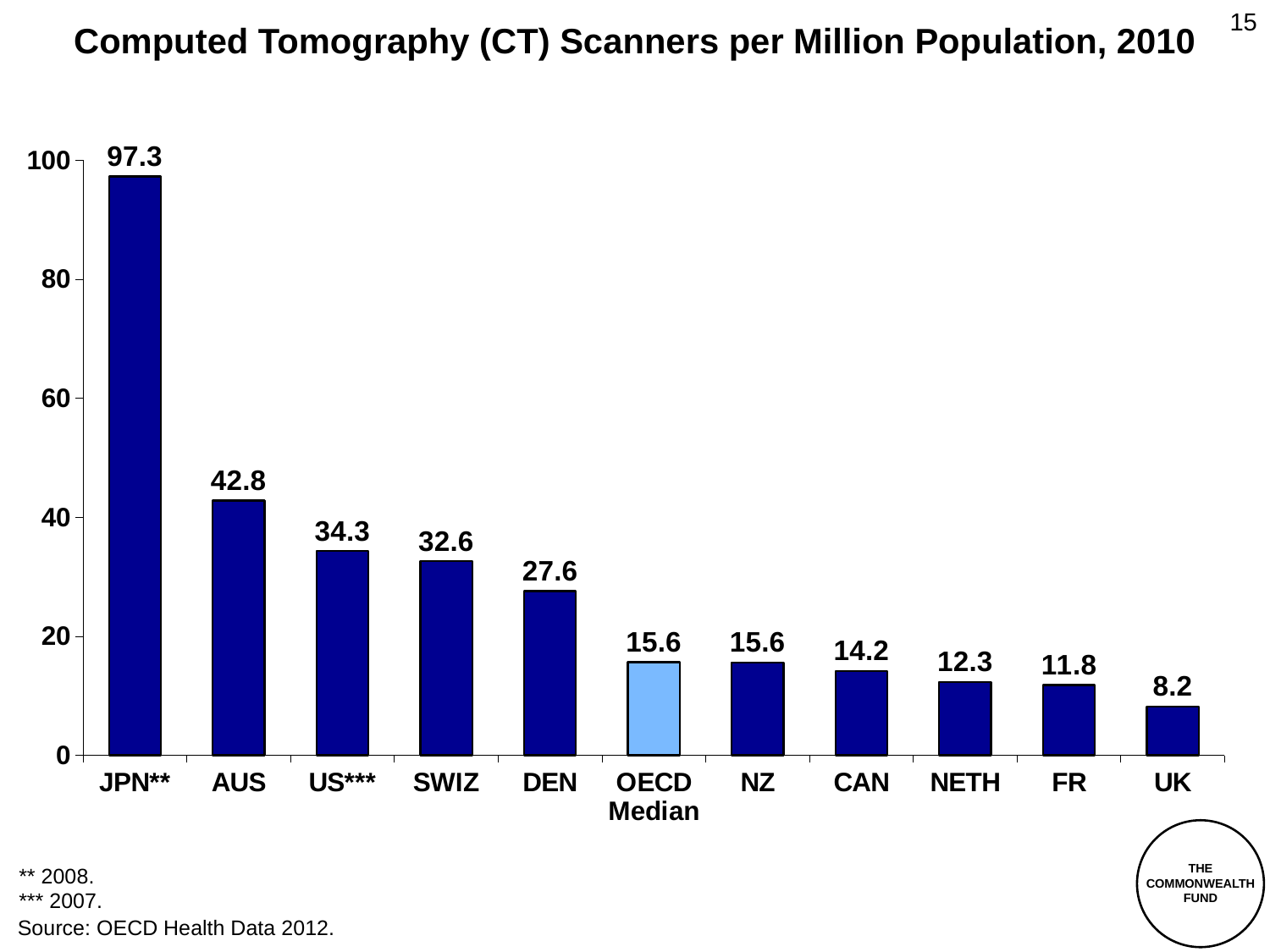
What is the value for CAN? 14.2 Which bar is shown in a lighter blue colour than the others? OECD Median What is the difference between the values for JPN** and UK? 89.1 Which category has the lowest value? UK What is the value for the OECD Median? 15.6 Which category has the highest value? JPN** Which is larger, the value for SWIZ or the value for DEN? SWIZ What is the value for JPN**? 97.3 How many categories are shown on the x axis? 11 What is the difference between the values for AUS and US***? 8.5 What kind of chart is shown on the slide? bar chart Is the value for NETH greater or less than 20? less